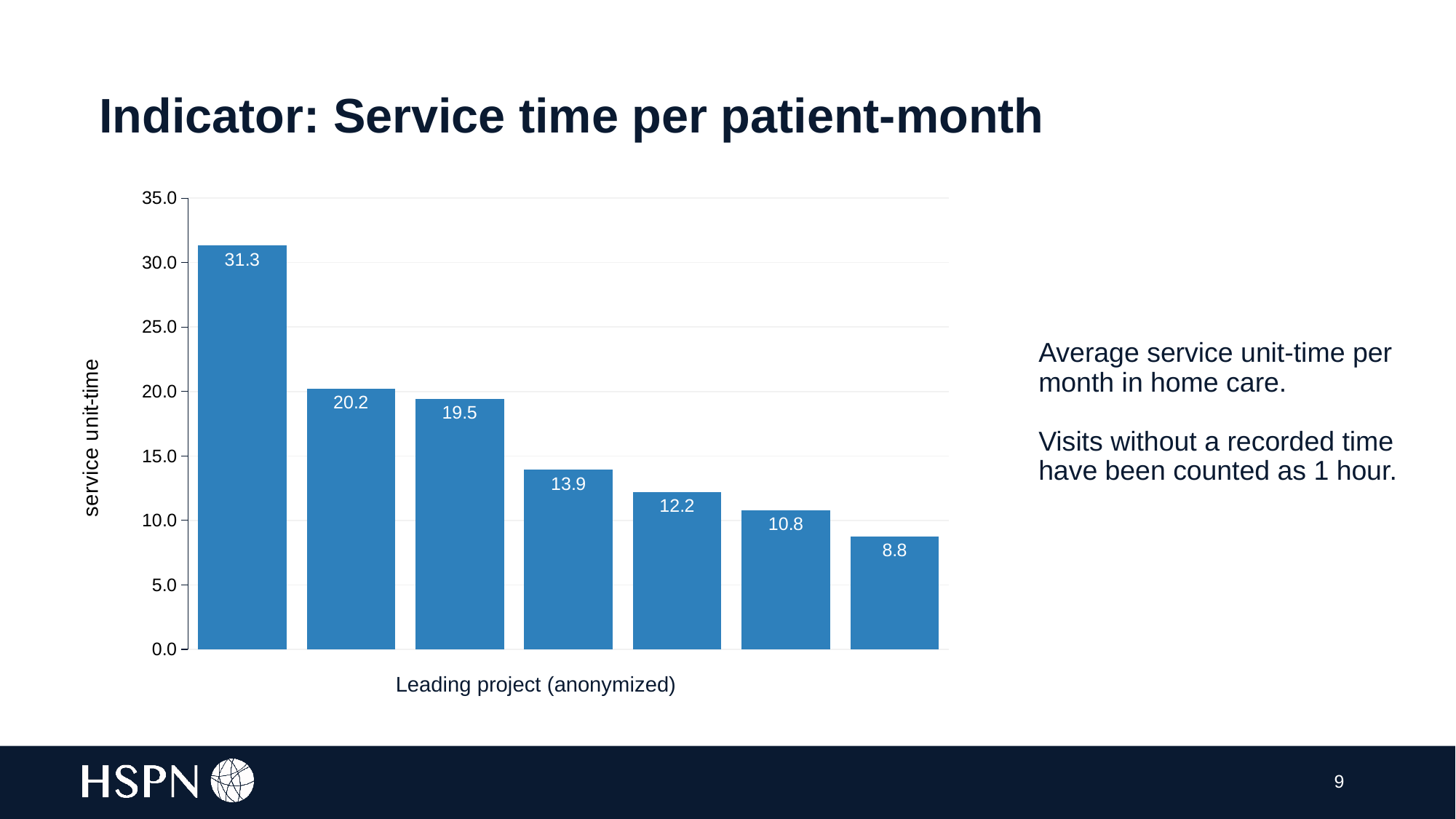
What is the value of the sixth bar from the left? 10.8 What is the difference between the leftmost bar (31.3) and the rightmost bar (8.8)? 22.5 Which is larger, the second bar (20.2) or the third bar (19.5)? the second bar (20.2) Do the bar values rise or fall from left to right across the chart? fall What is the value of the shortest bar in the chart? 8.8 What kind of chart is shown on the slide? bar chart What is the value of the tallest bar in the chart? 31.3 What is the value of the fourth bar from the left? 13.9 How many bars are plotted in the chart? 7 What is the value of the second bar from the left? 20.2 What is the label on the horizontal axis of the chart? Leading project (anonymized) What is the label on the vertical axis of the chart? service unit-time